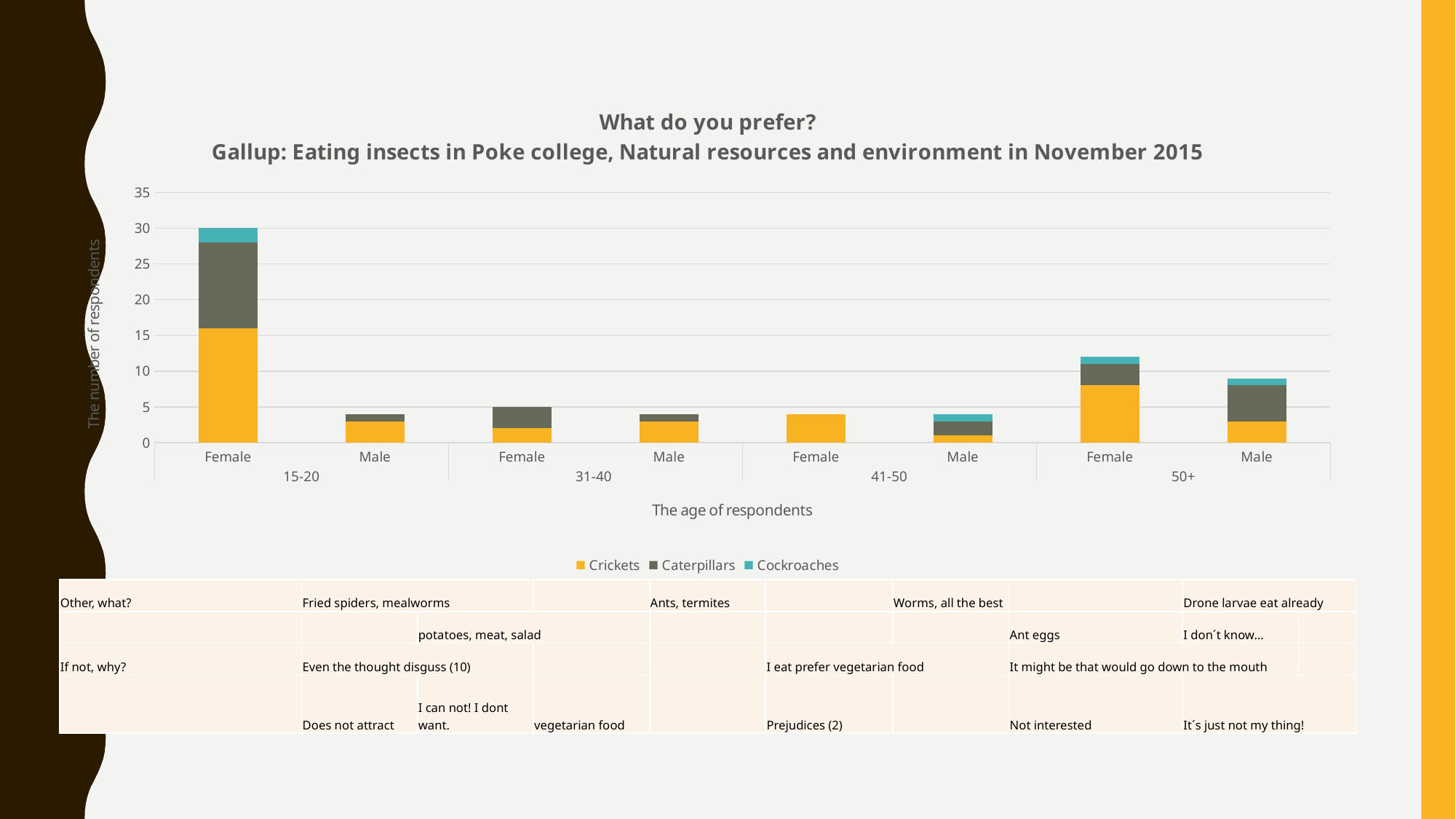
Which series are listed in the legend? Crickets, Caterpillars, Cockroaches Is the total for Female in the 15-20 group greater or less than 20? greater Is the total for Male in the 15-20 group greater or less than 5? less Which bar has the highest total number of respondents? Female, 15-20 How many series does the legend list? 3 How many age groups are shown on the x axis? 4 Which has a larger total, Female 50+ or Male 50+? Female 50+ How many stacked bars are plotted in the chart? 8 What kind of chart is shown on the slide? Stacked bar chart What is the label of the x axis? The age of respondents Is the total for Female in the 50+ group greater or less than 10? greater